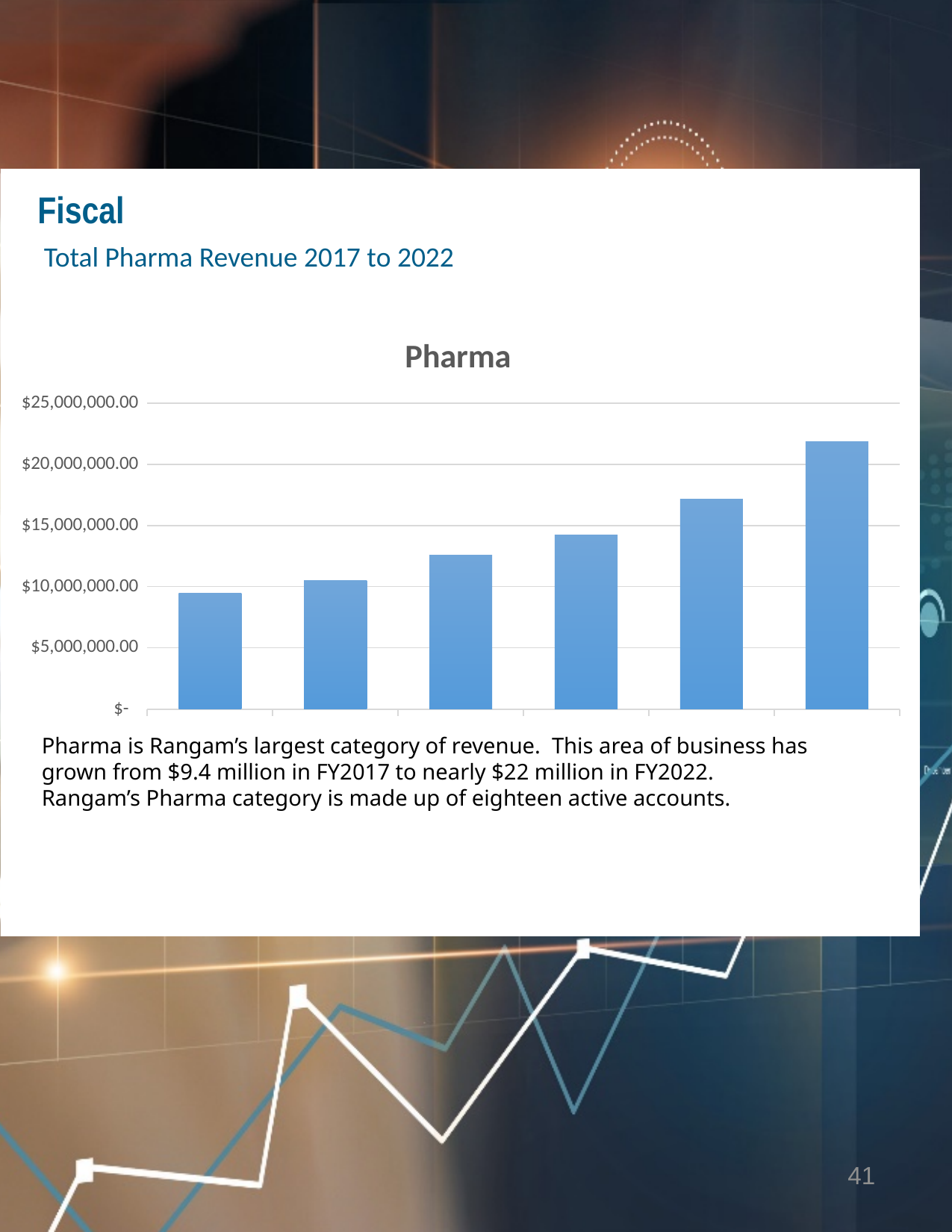
Is the value of the last (rightmost) bar greater or less than $20,000,000.00? greater Which bar is the tallest in the Pharma chart? the rightmost (last) bar Which bar is the shortest in the Pharma chart? the leftmost (first) bar Is the value of the third bar from the left greater or less than $10,000,000.00? greater Is the value of the first (leftmost) bar greater or less than $10,000,000.00? less Which is larger, the fourth bar or the fifth bar from the left? the fifth bar How many bars does the Pharma chart contain? 6 What is the highest value labelled on the vertical axis? $25,000,000.00 Do the bar values rise or fall from left to right across the chart? rise What kind of chart is shown on the slide? bar chart What is the title of the chart? Pharma